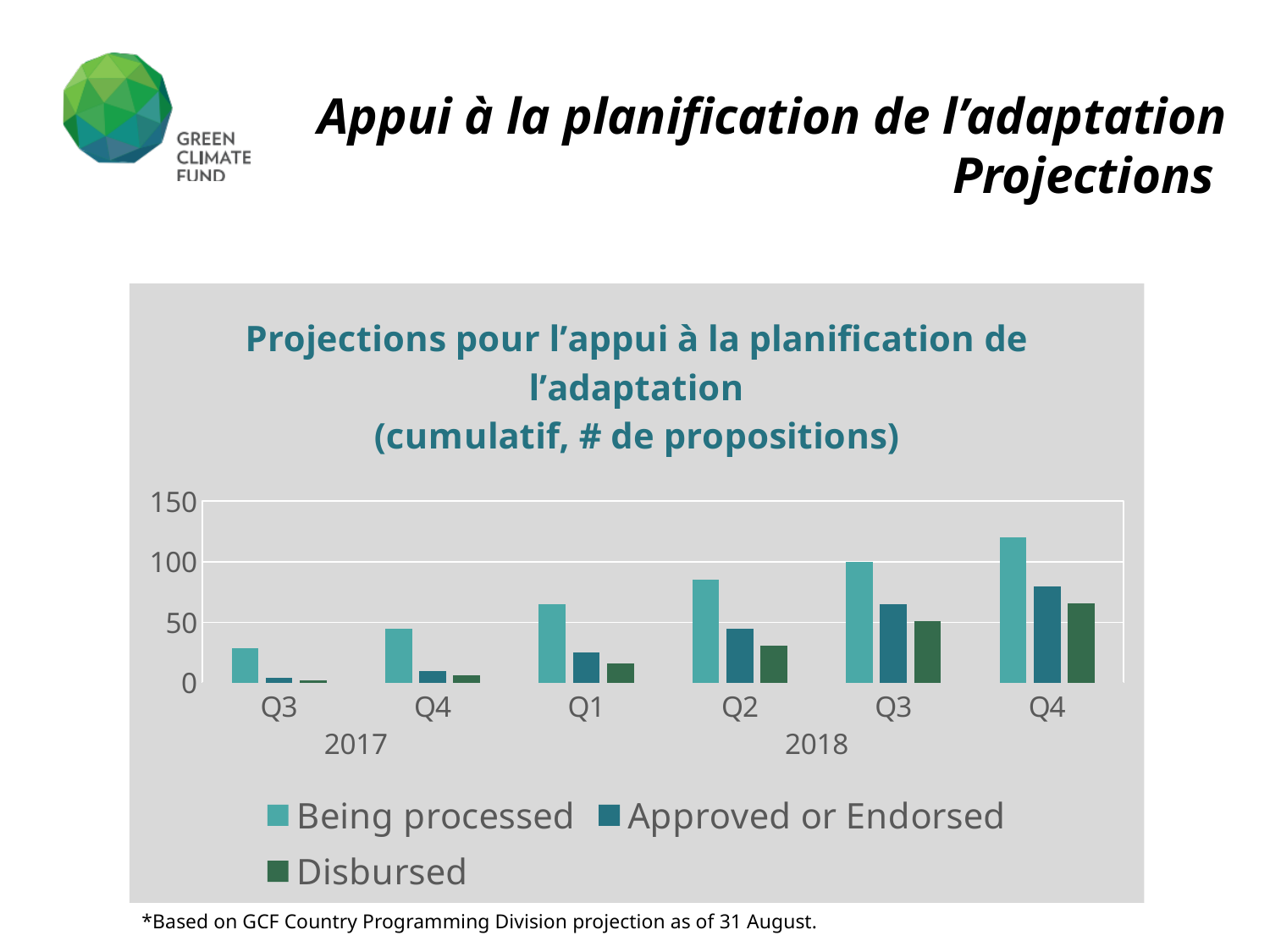
What kind of chart is shown on the slide? bar chart In which quarter is the 'Being processed' value lowest? Q3 2017 Do the 'Being processed' values rise or fall from Q3 2017 to Q4 2018? rise What are the three series named in the legend? Being processed, Approved or Endorsed, Disbursed How many quarters are shown along the x axis? 6 Is the 'Approved or Endorsed' value for Q1 2018 greater or less than 50? less Is the 'Disbursed' value for Q4 2018 greater or less than 50? greater In which quarter is the 'Being processed' value highest? Q4 2018 How many series does the legend list? 3 Is the 'Being processed' value for Q2 2018 greater or less than 100? less In Q4 2018, which is larger: 'Approved or Endorsed' or 'Disbursed'? Approved or Endorsed